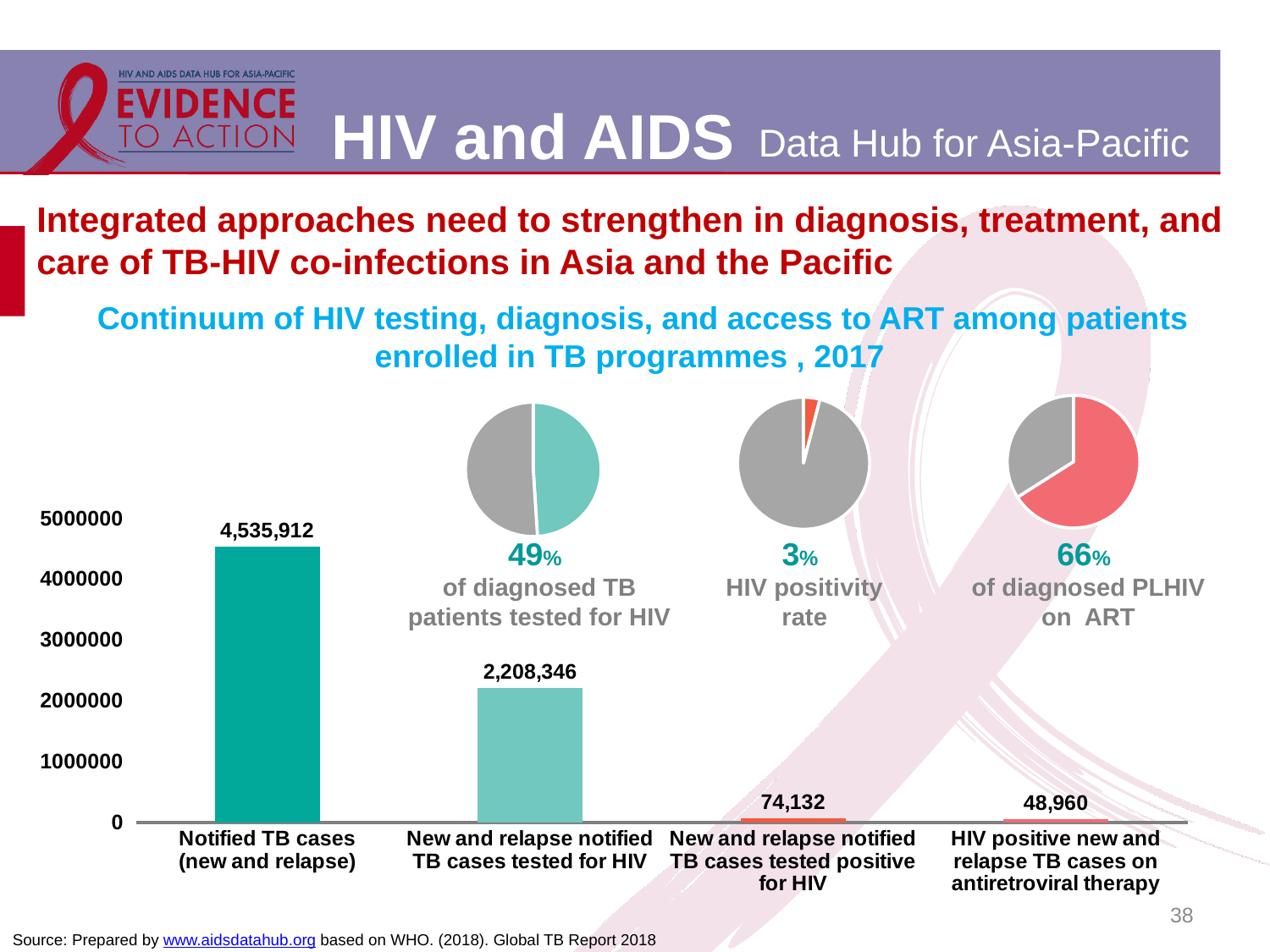
In the bar chart, what is the value for HIV positive new and relapse TB cases on antiretroviral therapy? 48,960 In the bar chart, what is the value for New and relapse notified TB cases tested for HIV? 2,208,346 In the bar chart, how many categories are shown on the x axis? 4 In the bar chart, which category has the highest value? Notified TB cases (new and relapse) In the bar chart, what is the difference between New and relapse notified TB cases tested positive for HIV and HIV positive new and relapse TB cases on antiretroviral therapy? 25,172 In the bar chart, what is the difference between Notified TB cases (new and relapse) and New and relapse notified TB cases tested for HIV? 2,327,566 In the bar chart, what is the value for Notified TB cases (new and relapse)? 4,535,912 In the bar chart, which category has the lowest value? HIV positive new and relapse TB cases on antiretroviral therapy In the bar chart, what is the value for New and relapse notified TB cases tested positive for HIV? 74,132 What percentage of diagnosed PLHIV are on ART, according to the third pie chart? 66% What percentage of diagnosed TB patients were tested for HIV, according to the first pie chart? 49% In the bar chart, do the values rise or fall from left to right along the x axis? fall